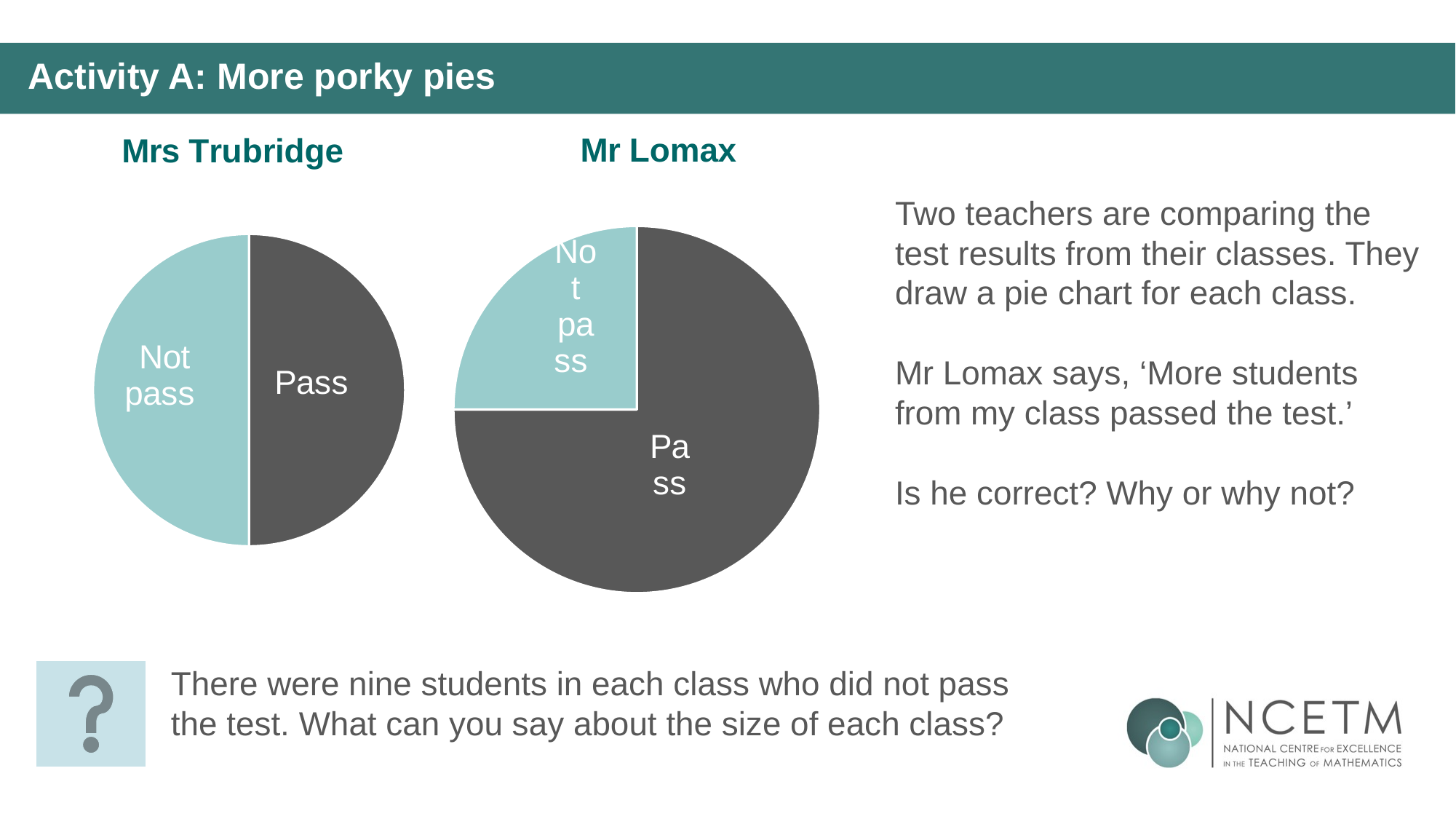
What are the two categories shown in the Mrs Trubridge pie chart? Not pass and Pass In the Mr Lomax pie chart, which slice is larger, Pass or Not pass? Pass How many pie charts are shown on the slide? 2 What kind of chart is used for Mr Lomax's class? Pie chart How many slices does the Mr Lomax pie chart have? 2 How many slices does the Mrs Trubridge pie chart have? 2 In the Mrs Trubridge pie chart, what colour is the Pass slice? Dark grey In the Mr Lomax pie chart, which category has the smallest slice? Not pass In the Mr Lomax pie chart, which category has the largest slice? Pass What kind of chart is used for Mrs Trubridge's class? Pie chart